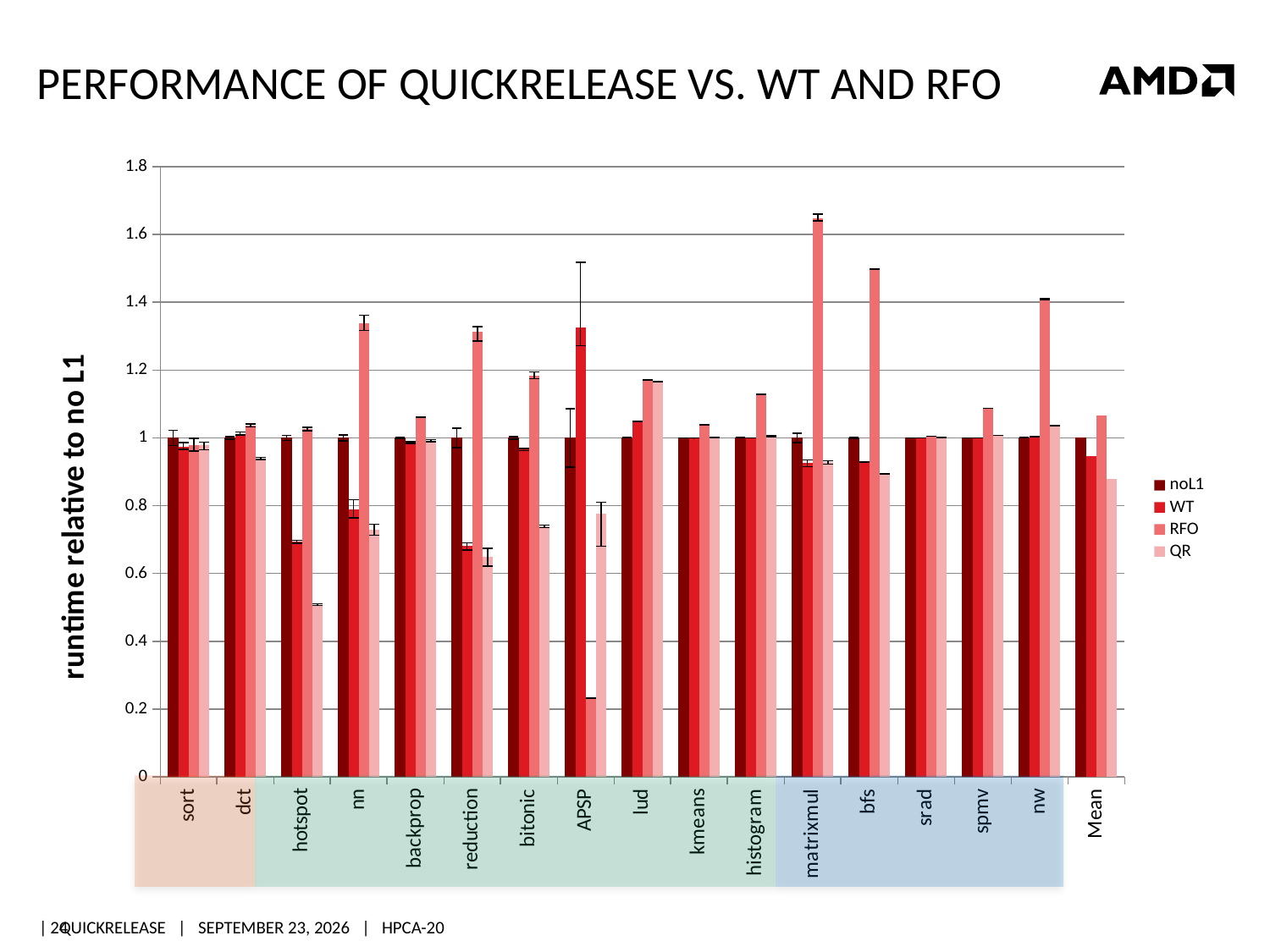
Which category has the highest RFO bar? matrixmul How many categories are shown along the x axis? 17 How many series does the legend list? 4 Is the WT value for hotspot greater or less than 0.8? less Is the RFO value for nn greater or less than 1.2? greater What is the title of the y axis? runtime relative to no L1 Is the QR value for APSP greater or less than 0.4? greater Which category has the lowest QR bar? hotspot What kind of chart is shown on the slide? bar chart Which series is listed last in the legend? QR For hotspot, which is larger, the WT value or the QR value? WT